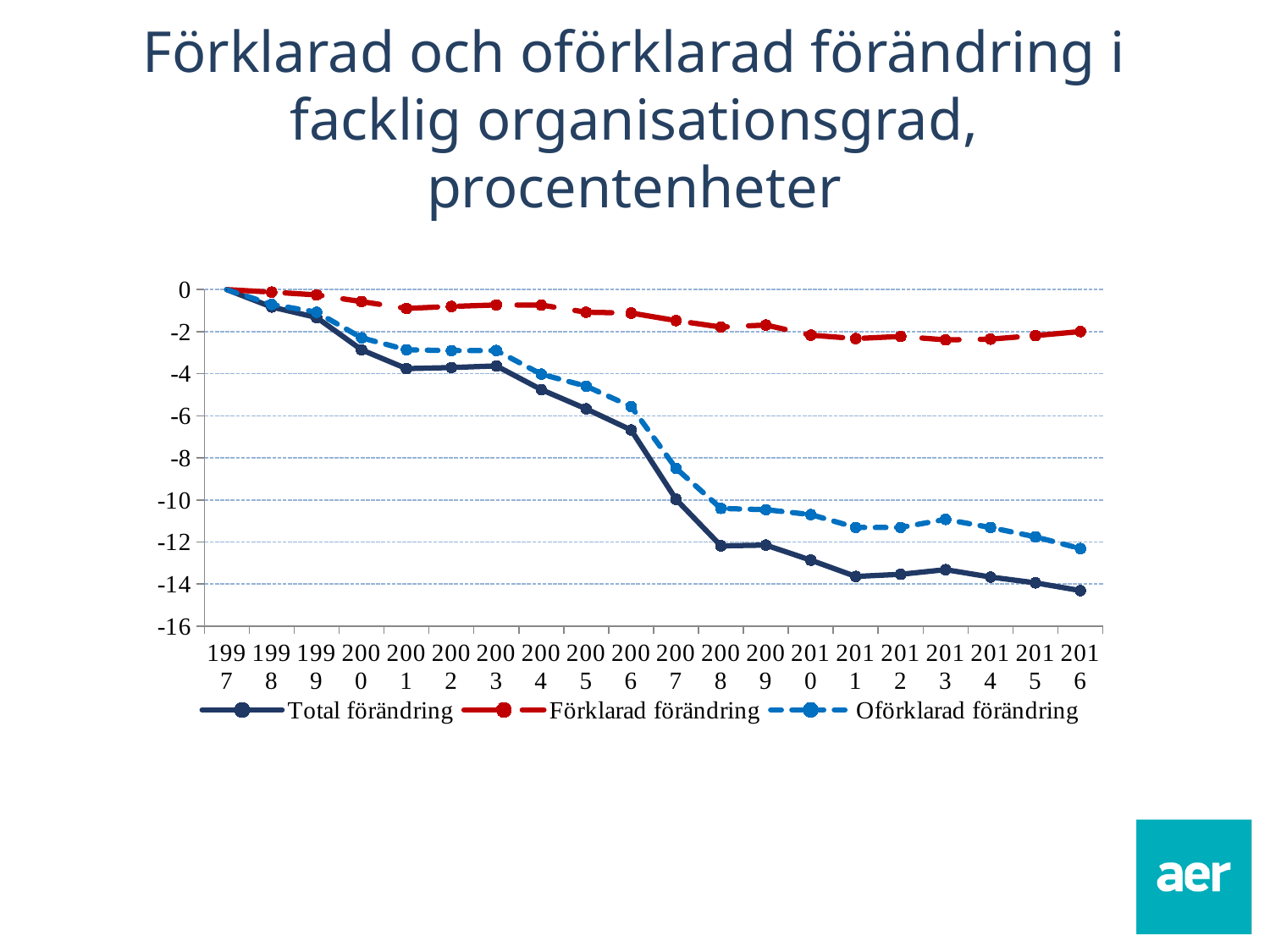
How many years are plotted along the x axis? 20 Is the value for Förklarad förändring in 2005 greater or less than -2? greater Is the value for Oförklarad förändring in 2007 greater or less than -8? less Is the value for Total förändring in 2016 greater or less than -14? less What kind of chart is shown on the slide? line chart Do the values of Total förändring rise or fall from 1997 to 2016? fall What is the value of Total förändring in 1997? 0 How many series does the legend list? 3 Which series is drawn with a dashed line? Oförklarad förändring Which is higher in 2016, Total förändring or Förklarad förändring? Förklarad förändring In which year does Total förändring reach its lowest value? 2016